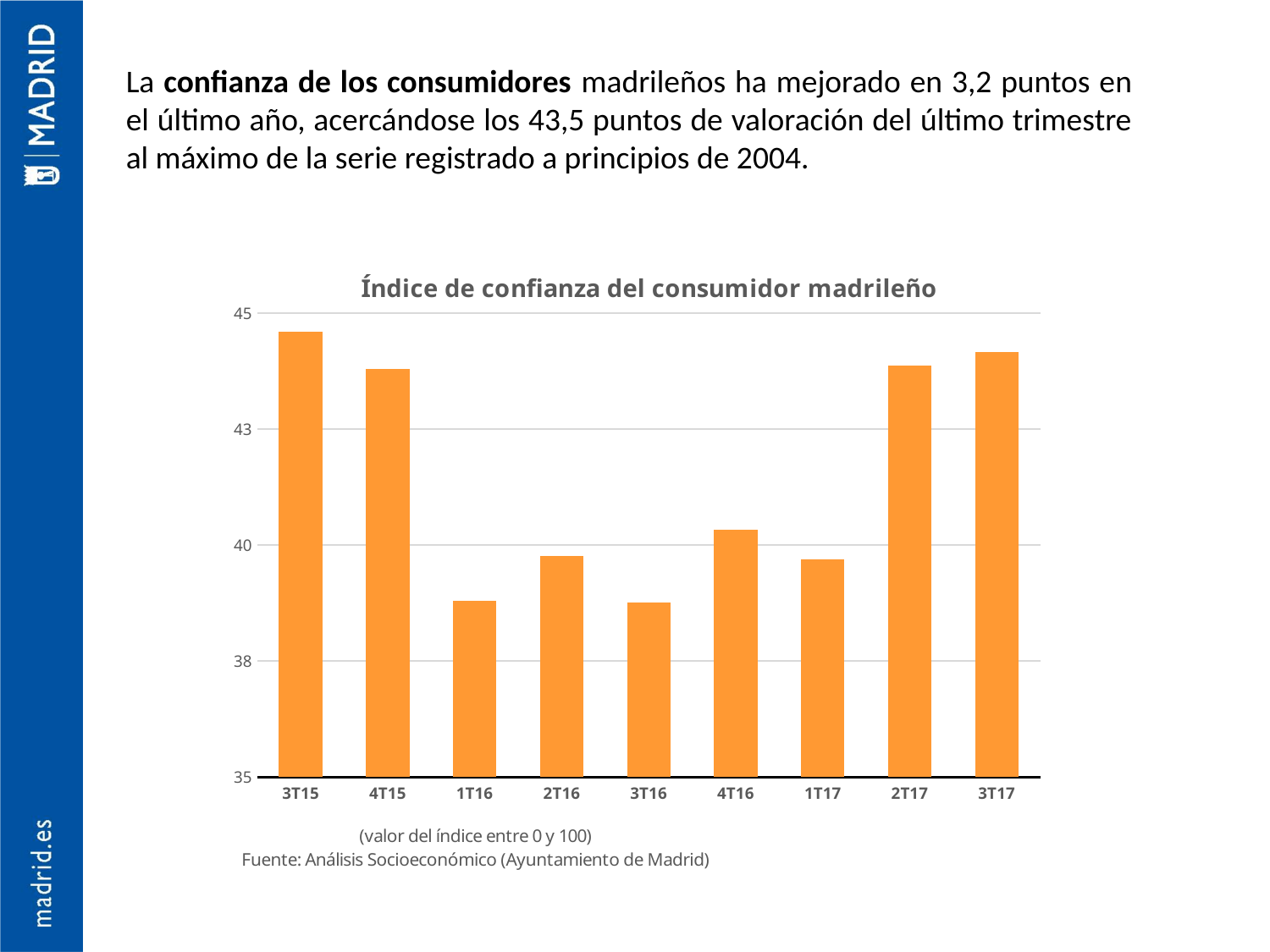
Is the value for 2T17 greater or less than 43? greater Is the value for 4T16 greater or less than 40? greater Is the value for 3T16 greater or less than 40? less What kind of chart is shown on the slide? Bar chart Which quarter has the highest value in the chart? 3T15 What is the title of the chart? Índice de confianza del consumidor madrileño Do the values rise or fall from 3T15 to 1T16? fall Which is larger, the value for 4T16 or the value for 3T16? 4T16 How many quarters are shown on the x axis of the chart? 9 Which is larger, the value for 3T15 or the value for 1T16? 3T15